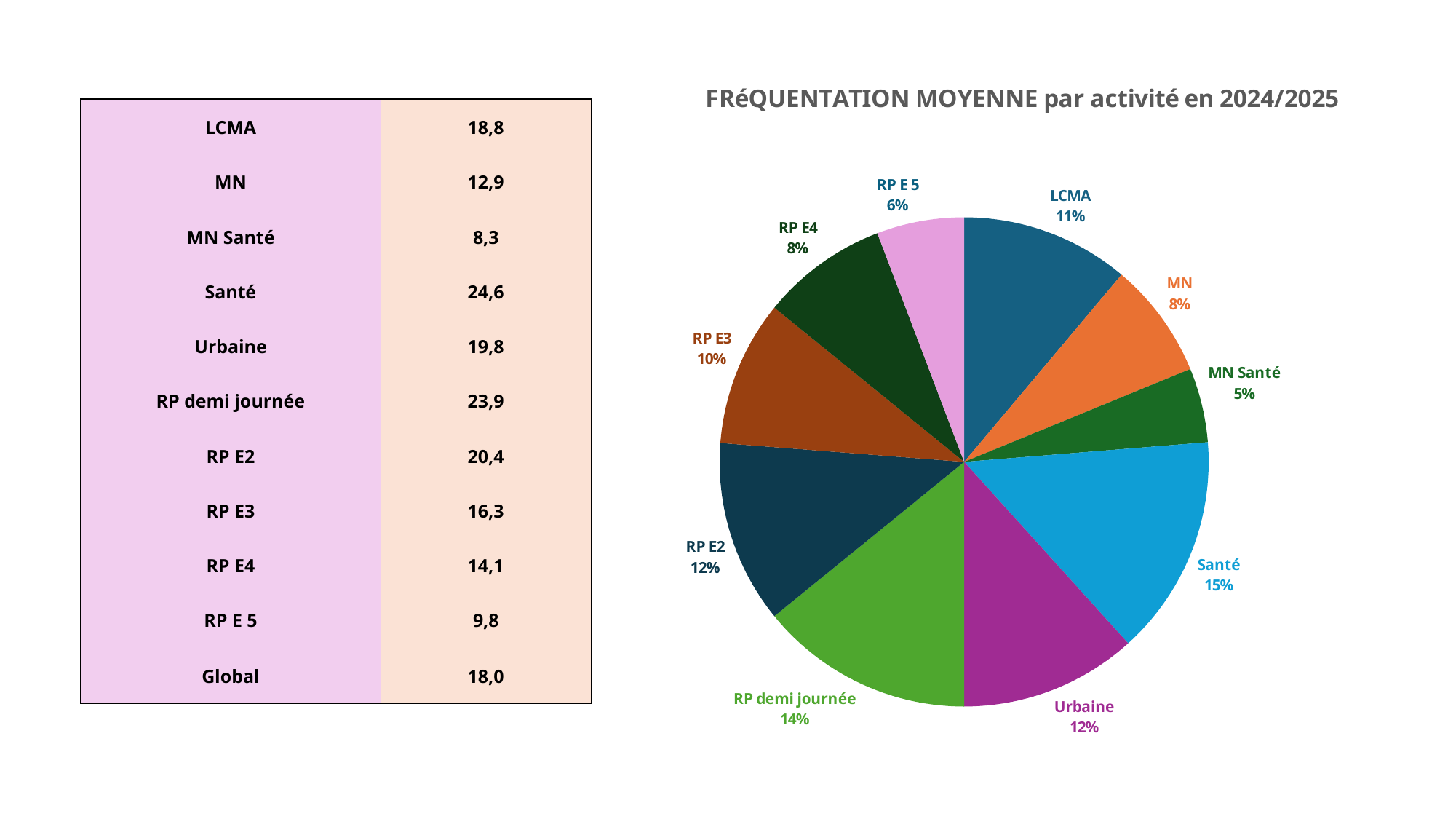
Which activity has the smallest slice of the pie? MN Santé What kind of chart is shown on the slide? Pie chart What percentage is shown for RP E 5? 6% What is the difference in percentage points between the Santé slice and the MN Santé slice? 10 percentage points How many slices does the pie chart have? 10 Which slice is larger, LCMA or RP E3? LCMA What percentage is shown for RP demi journée? 14% What is the title of the chart? FRéQUENTATION MOYENNE par activité en 2024/2025 Which activity has the largest slice of the pie? Santé What share of the pie does Santé represent? 15% What percentage is shown for RP E2? 12% What percentage is shown for MN Santé? 5%